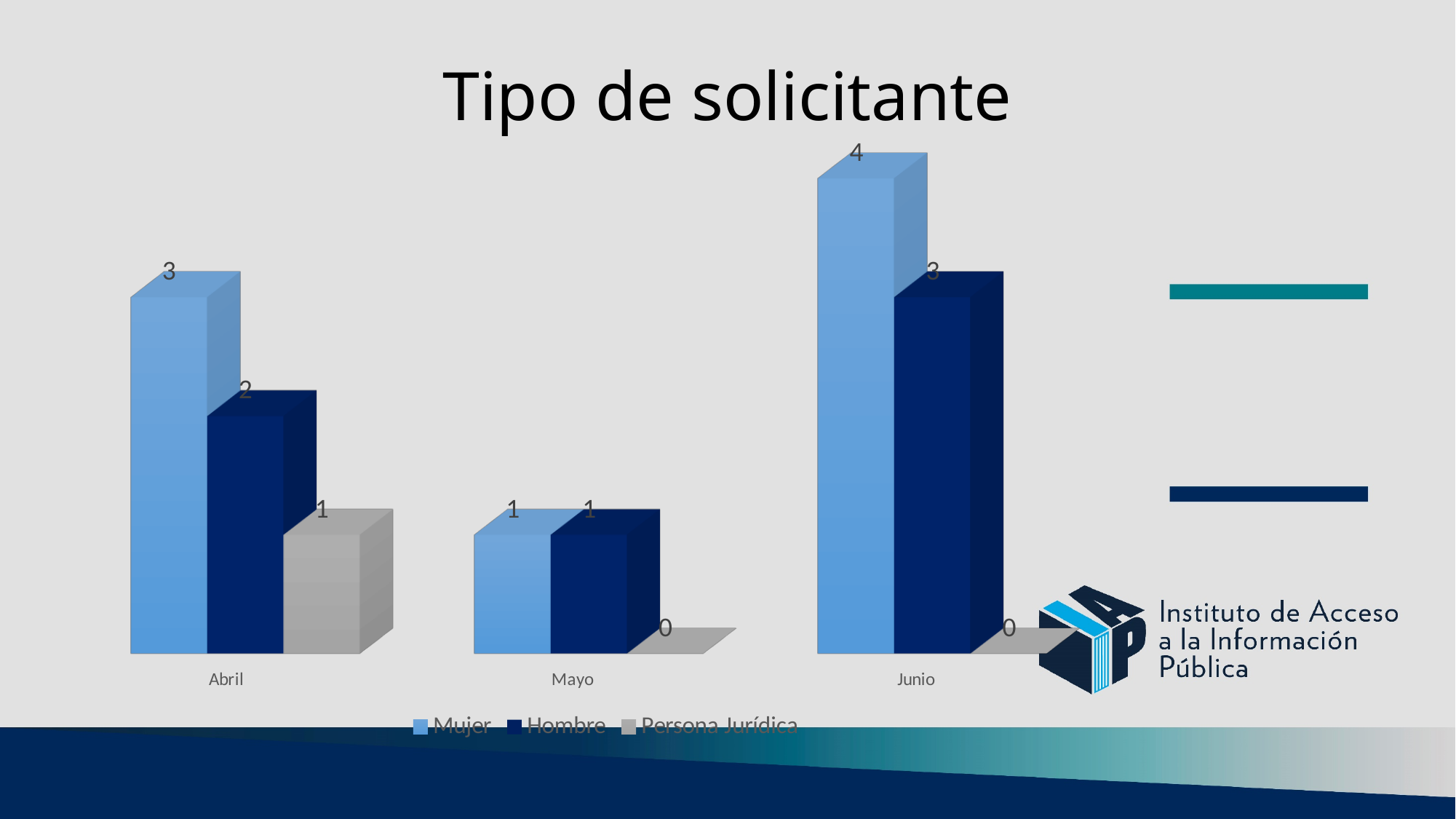
What is the value for Hombre in Abril? 2 How many months are shown on the x axis? 3 In which month is the value for Hombre lowest? Mayo How many series does the legend list? 3 What is the value for Persona Jurídica in Mayo? 0 What is the value for Hombre in Junio? 3 What kind of chart is shown on the slide? Bar chart Which is larger: the Mujer value in Abril or the Hombre value in Abril? Mujer In which month is the value for Mujer highest? Junio What is the difference between the Mujer value in Junio and the Mujer value in Abril? 1 What is the title of the chart? Tipo de solicitante What is the value for Mujer in Abril? 3